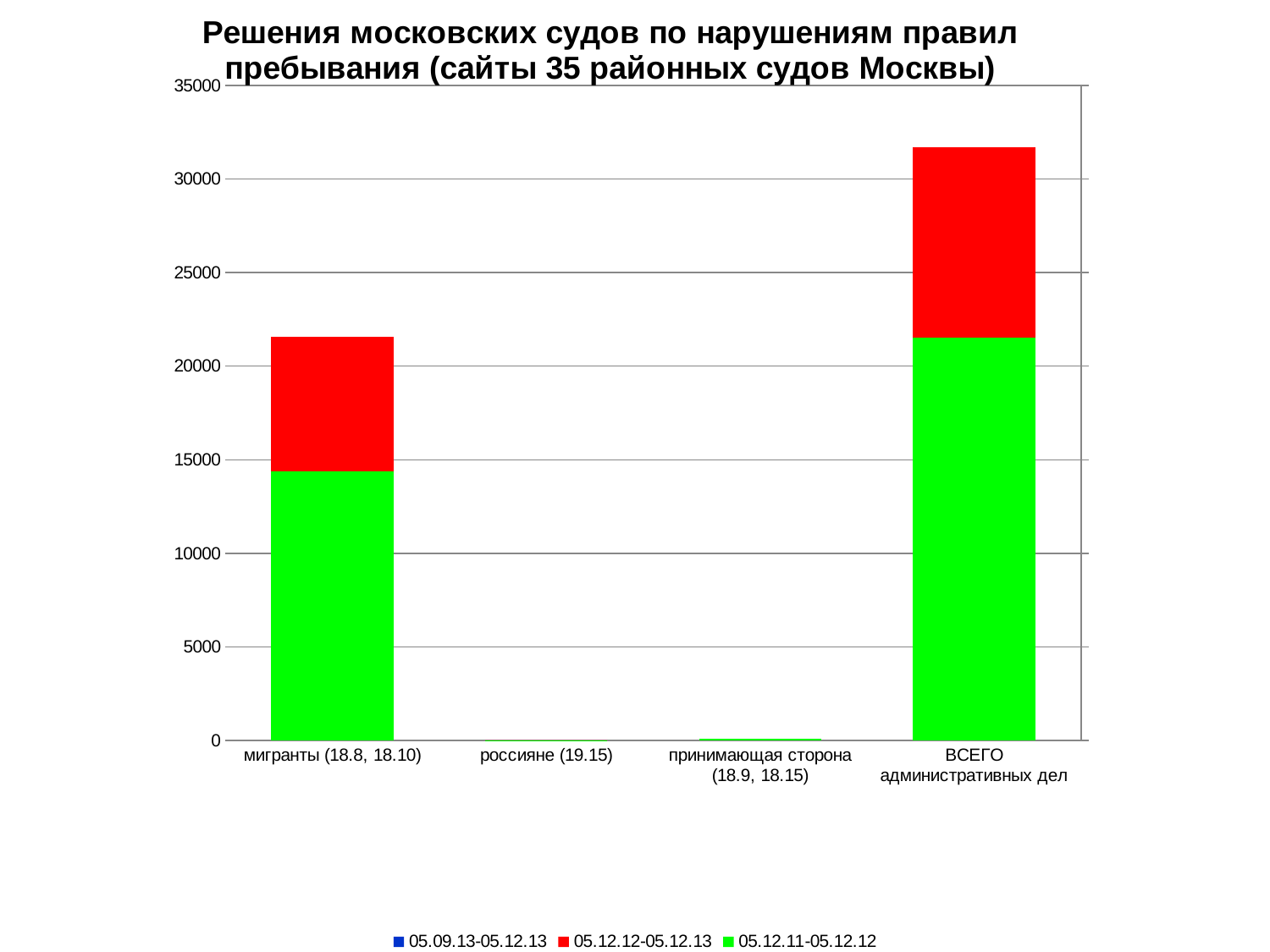
What colour represents the 05.12.11-05.12.12 series in the legend? green How many series does the legend list? 3 How many categories are shown along the x axis? 4 In the мигранты (18.8, 18.10) bar, which segment is larger: 05.12.12-05.12.13 or 05.12.11-05.12.12? 05.12.11-05.12.12 Is the 05.12.11-05.12.12 segment for ВСЕГО административных дел greater or less than 20000? greater Which total bar is larger: мигранты (18.8, 18.10) or ВСЕГО административных дел? ВСЕГО административных дел Is the total bar for мигранты (18.8, 18.10) greater or less than 20000? greater Is the 05.12.11-05.12.12 segment for мигранты (18.8, 18.10) greater or less than 15000? less Which category has the highest total bar? ВСЕГО административных дел What kind of chart is shown on the slide? bar chart